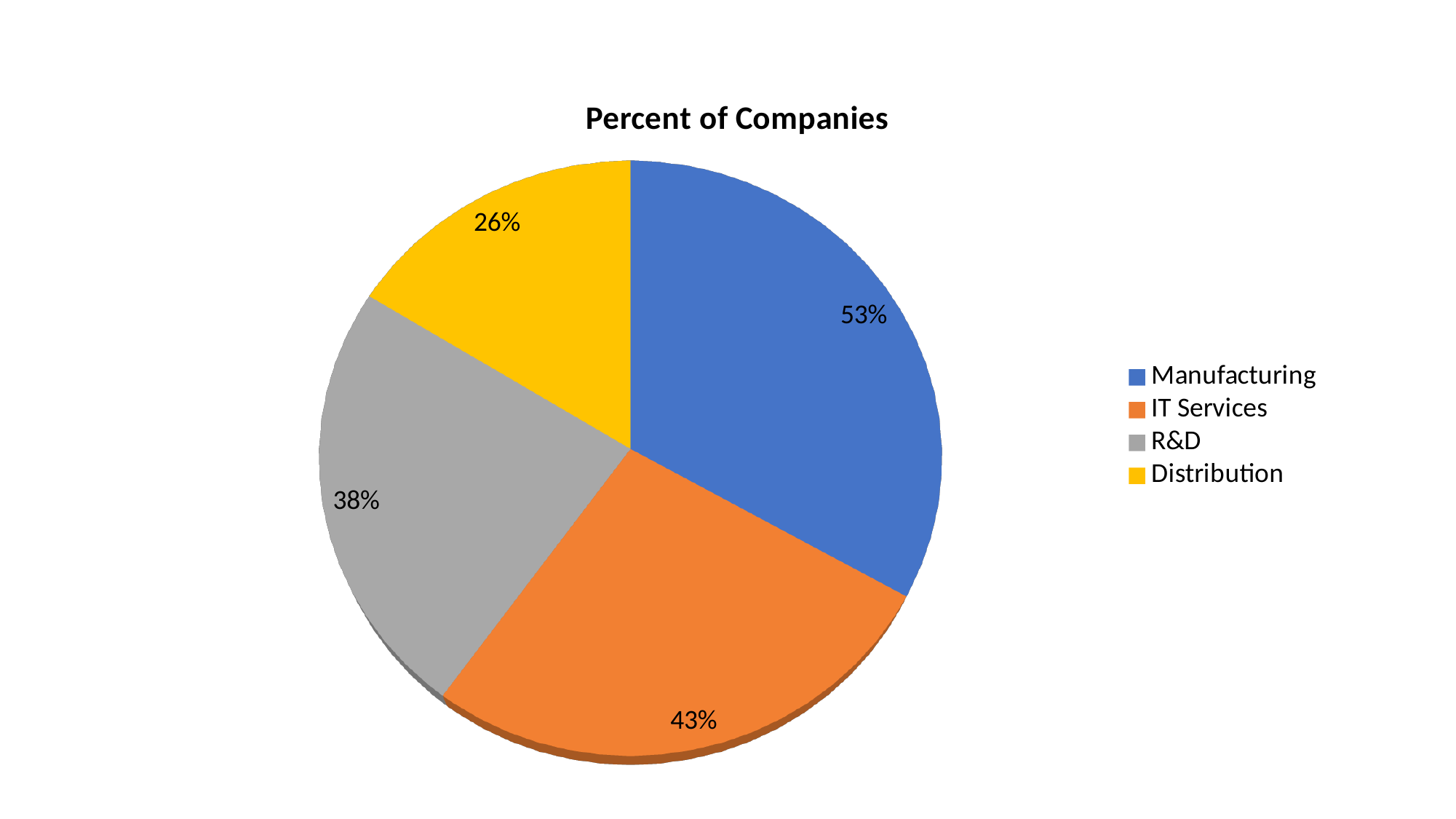
Which is larger, the value for IT Services or the value for R&D? IT Services How many categories does the legend list? 4 What value is labelled on the IT Services slice? 43% What is the difference between the labelled values for Manufacturing and Distribution? 27% What is the title of the chart? Percent of Companies What kind of chart is shown on the slide? pie chart Which category has the largest slice? Manufacturing What colour is the R&D slice? grey Which category has the smallest slice? Distribution What value is labelled on the Manufacturing slice? 53% What value is labelled on the Distribution slice? 26% What value is labelled on the R&D slice? 38%